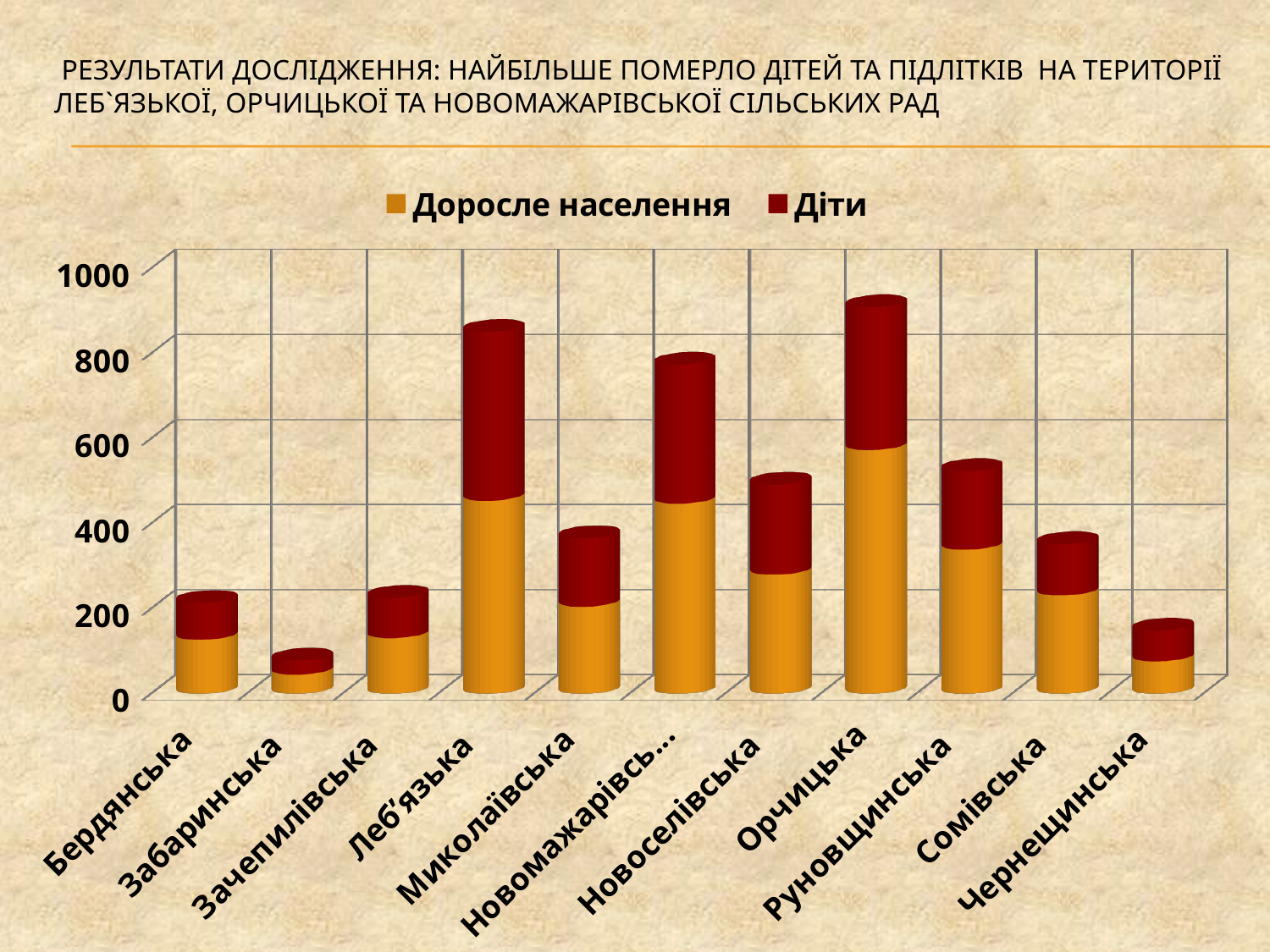
Which series is shown in dark red? Діти Is the total value for Орчицька greater or less than 800? greater Is the total value for Забаринська greater or less than 200? less What are the two series named in the legend? Доросле населення and Діти Which has the larger total stacked bar, Руновщинська or Сомівська? Руновщинська Which category has the tallest stacked bar? Орчицька What kind of chart is shown on the slide? Stacked bar chart Is the total value for Миколаївська greater or less than 400? less Which category has the shortest stacked bar? Забаринська How many categories (village councils) are shown on the x axis? 11 How many series does the legend list? 2